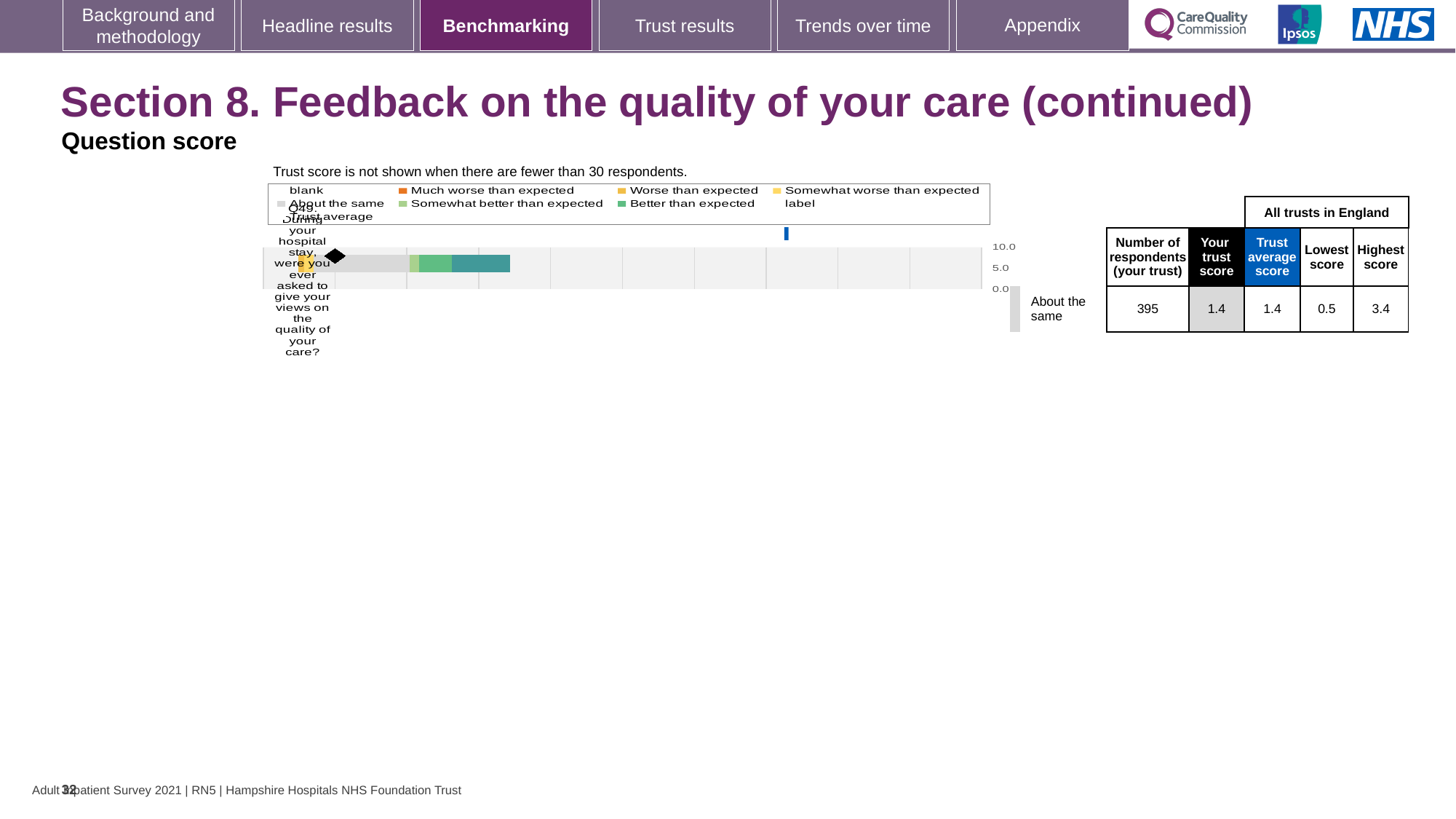
According to the table next to the chart, what is the number of respondents for your trust? 395 According to the table next to the chart, what is the lowest score among all trusts in England? 0.5 According to the table next to the chart, what is your trust score for Q49? 1.4 What kind of chart is shown on the slide? bar chart What colour does the legend use for 'Much worse than expected'? orange Which is larger, the highest score among all trusts or your trust score? the highest score among all trusts According to the table next to the chart, what is the trust average score for Q49? 1.4 Which survey question is plotted in the chart? Q49 Is the highest score among all trusts in England greater or less than 5.0? less What benchmark category label is shown beside the chart for Q49? About the same What is the difference between the highest score and the lowest score among all trusts in England? 2.9 According to the table next to the chart, what is the highest score among all trusts in England? 3.4